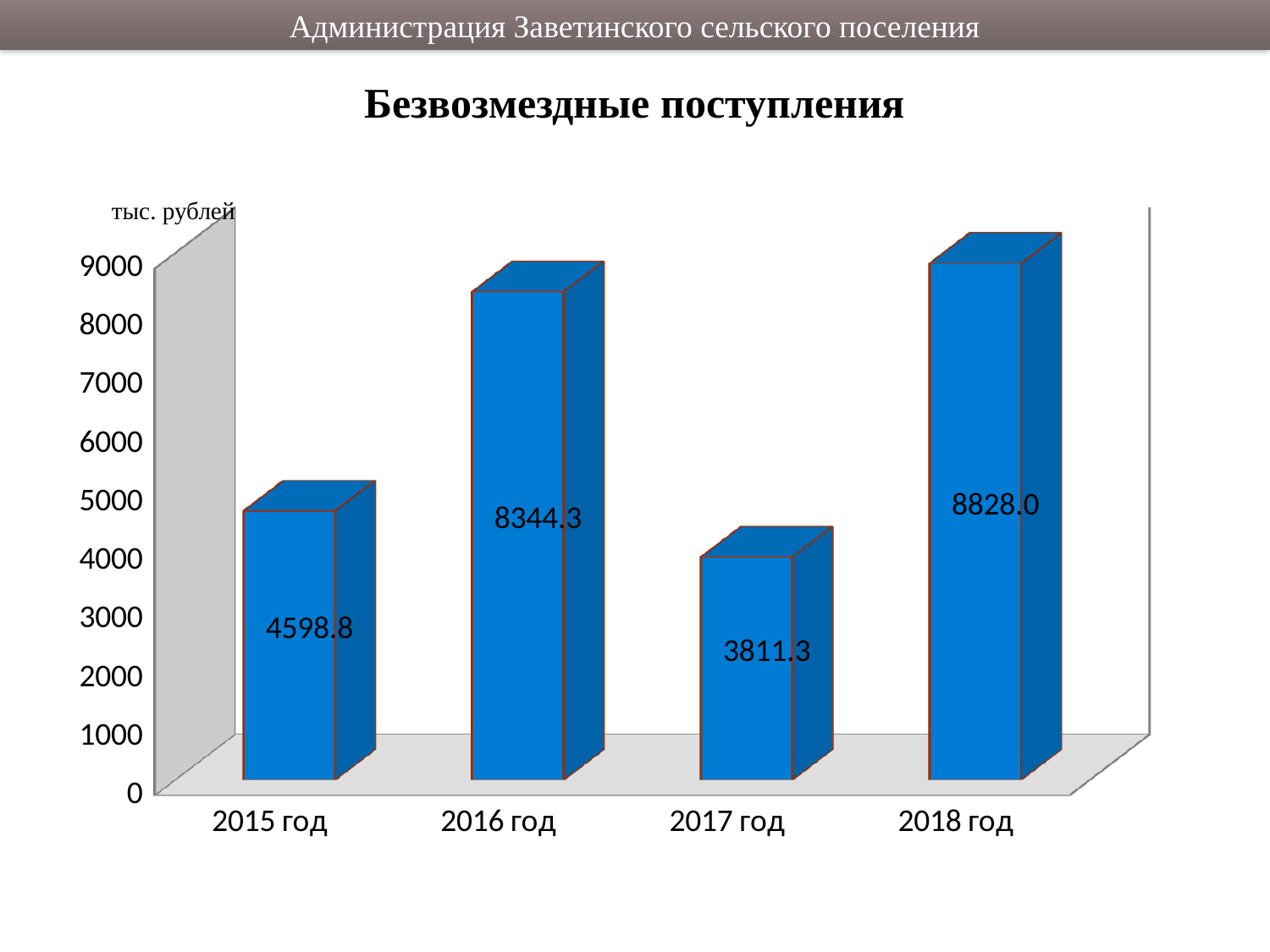
What is the difference between the values for 2018 год and 2017 год? 5016.7 What is the value for 2015 год? 4598.8 Which year has the highest value? 2018 год Which year has the lowest value? 2017 год What is the value for 2017 год? 3811.3 What kind of chart is shown on the slide? bar chart How many years are shown on the chart? 4 What is the value for 2018 год? 8828.0 Which is larger, the value for 2015 год or the value for 2017 год? 2015 год What is the title of the chart? Безвозмездные поступления What is the difference between the values for 2016 год and 2015 год? 3745.5 What is the value for 2016 год? 8344.3